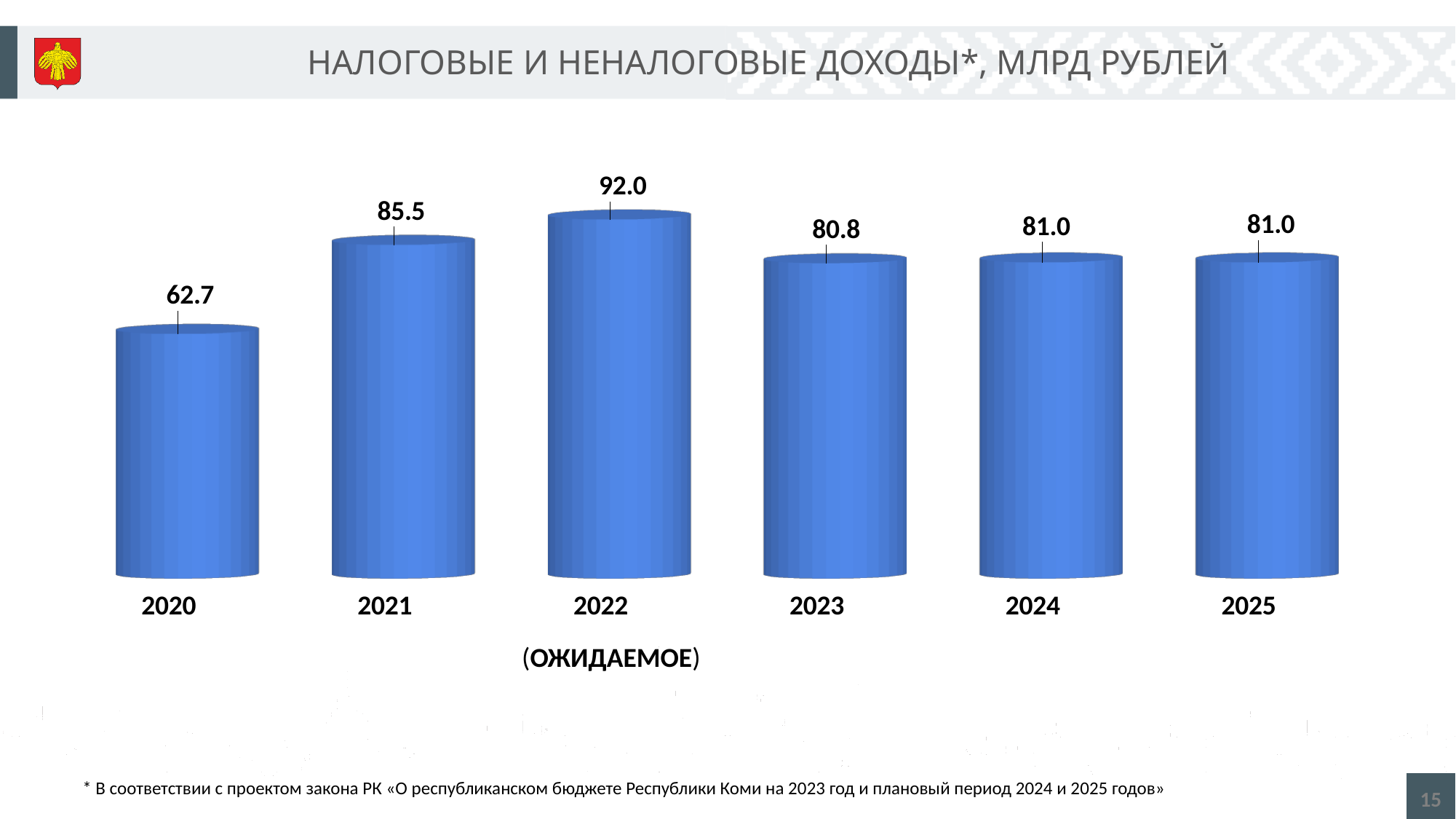
What is the title of the chart? НАЛОГОВЫЕ И НЕНАЛОГОВЫЕ ДОХОДЫ*, МЛРД РУБЛЕЙ What is the value for 2020? 62.7 Do the values rise or fall from 2020 to 2022? rise What is the difference between the values for 2022 and 2021? 6.5 Which is larger, the value for 2021 or the value for 2023? 2021 What is the difference between the values for 2021 and 2020? 22.8 What is the value for 2023? 80.8 What kind of chart is this? bar chart Which year has the highest value? 2022 How many years are shown on the chart? 6 Which year has the lowest value? 2020 What is the value for 2022? 92.0